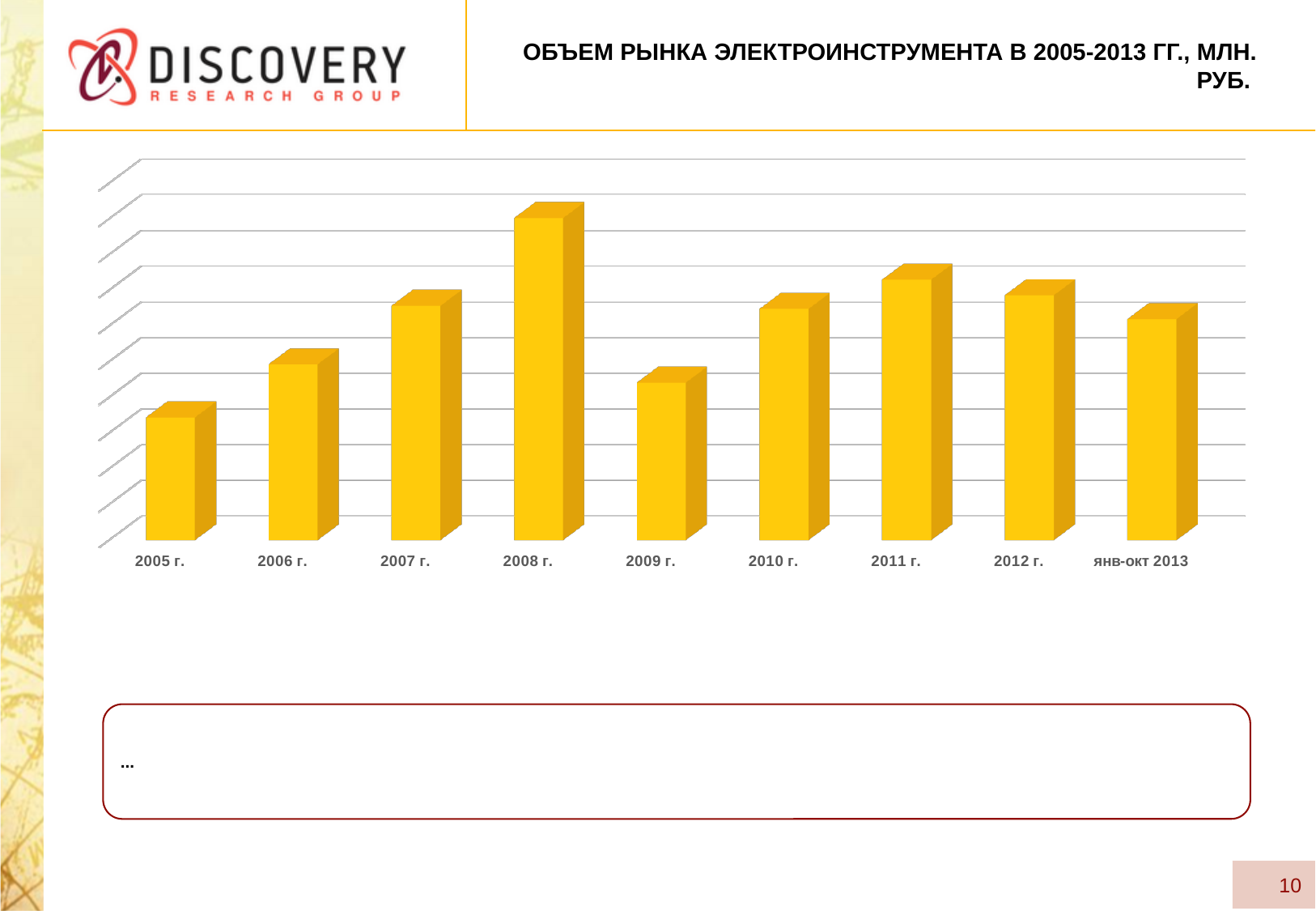
Which is larger, the value for 2011 г. or the value for 2012 г.? 2011 г. What kind of chart is shown on the slide? bar chart Which is larger, the value for 2012 г. or the value for янв-окт 2013? 2012 г. Which is larger, the value for 2008 г. or the value for 2009 г.? 2008 г. How many bars (periods) are shown in the chart? 9 What is the title of the chart on the slide? ОБЪЕМ РЫНКА ЭЛЕКТРОИНСТРУМЕНТА В 2005-2013 ГГ., МЛН. РУБ. Do the values rise or fall from 2005 г. to 2008 г.? rise What is the label of the last bar on the x axis? янв-окт 2013 Which period has the lowest bar in the chart? 2005 г. Which period has the highest bar in the chart? 2008 г. Do the values rise or fall from 2011 г. to янв-окт 2013? fall